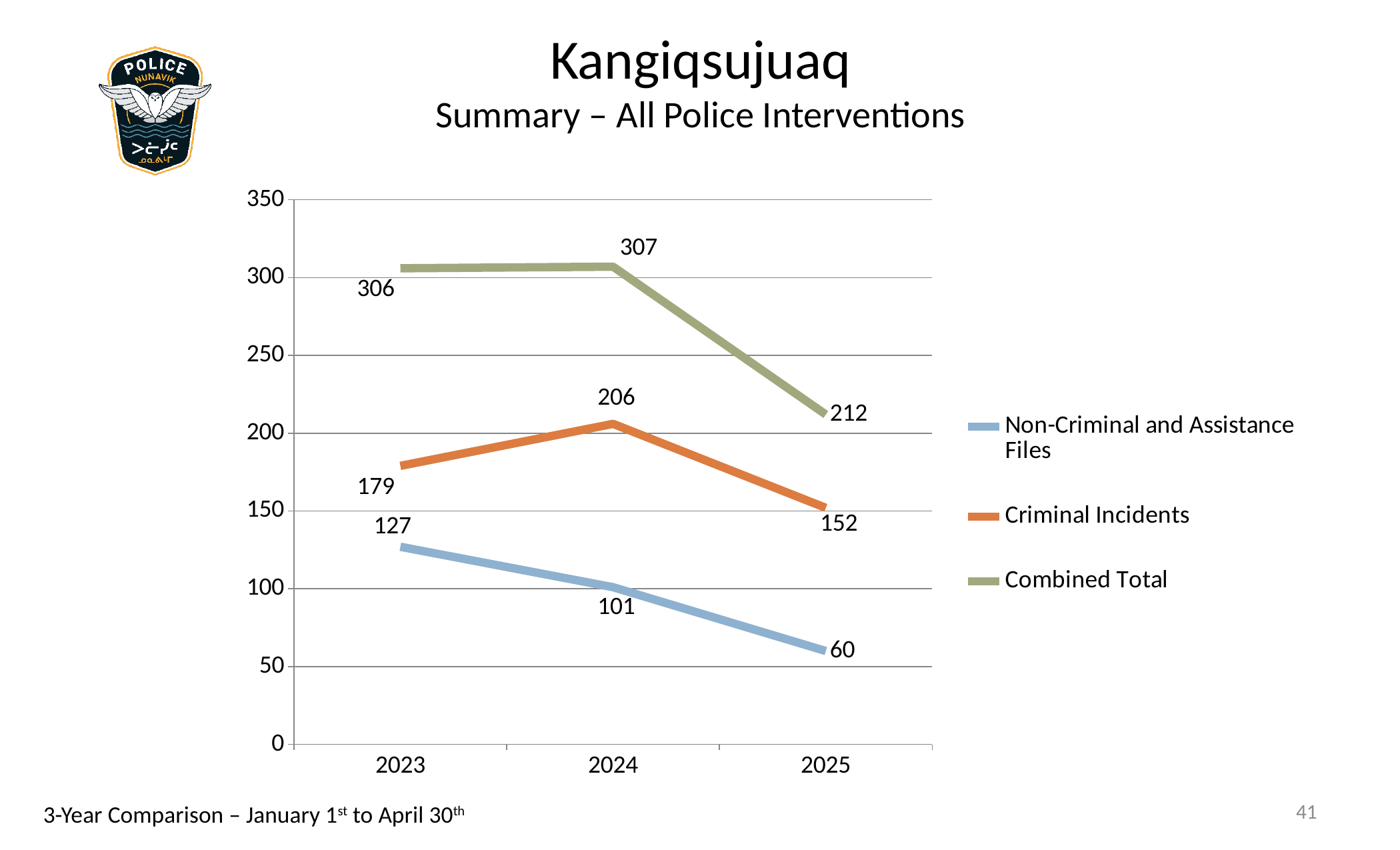
What kind of chart is shown on the slide? Line chart What is the value for Criminal Incidents in 2024? 206 In which year is the Combined Total highest? 2024 In which year is the value for Non-Criminal and Assistance Files lowest? 2025 How many years are shown on the x axis? 3 How many series does the legend list? 3 What is the value for Non-Criminal and Assistance Files in 2025? 60 What is the Combined Total for 2023? 306 Which is larger: Criminal Incidents in 2023 or Criminal Incidents in 2025? Criminal Incidents in 2023 Does the Non-Criminal and Assistance Files series rise or fall from 2023 to 2025? Fall What colour is the line for Combined Total? Green What is the difference between the Combined Total in 2024 and in 2025? 95